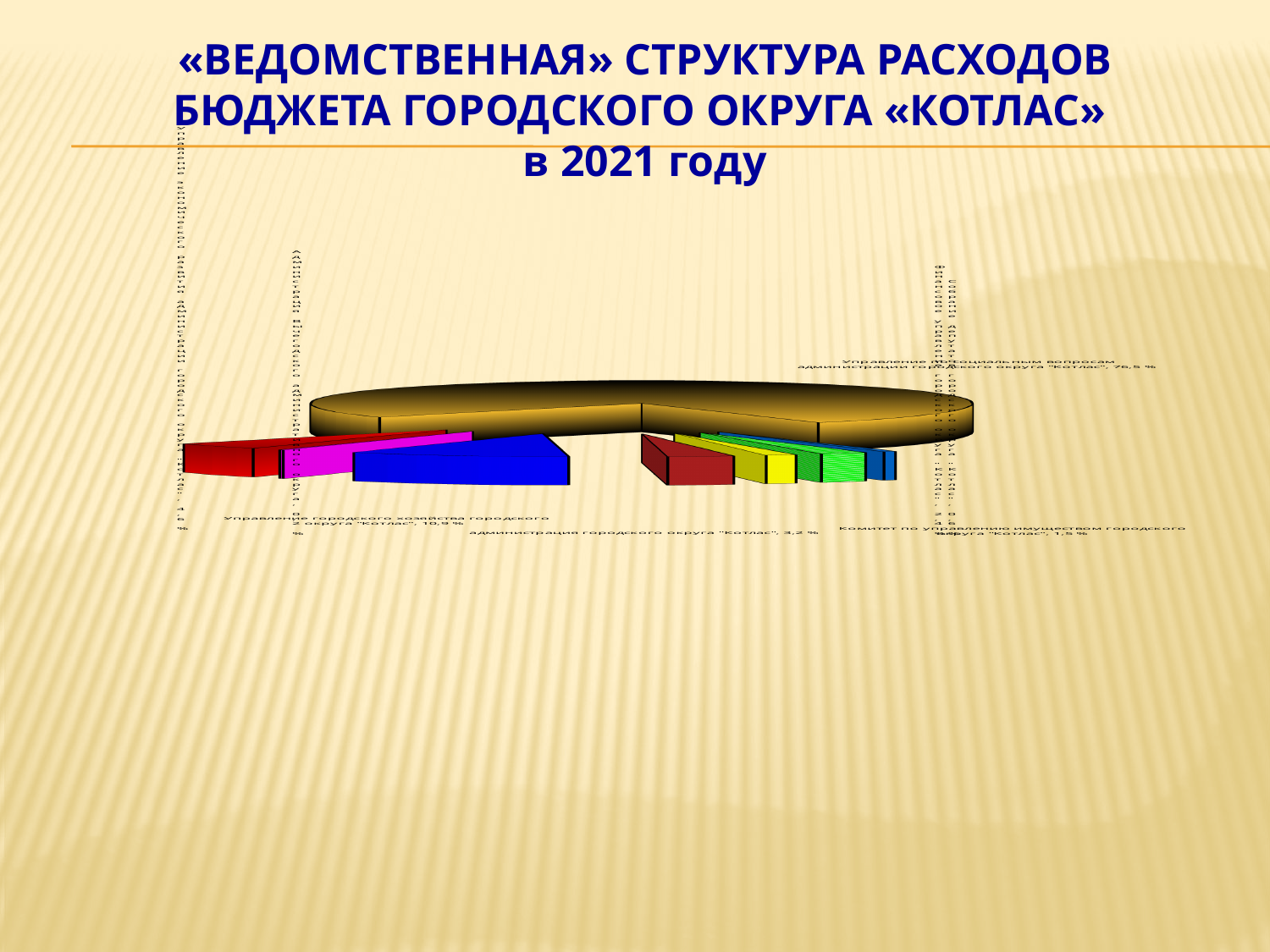
Which has a larger share: Управление городского хозяйства or администрация городского округа "Котлас"? Управление городского хозяйства By how many percentage points does the share of Управление по социальным вопросам exceed that of Управление городского хозяйства? 65,6 % Which year does the chart's title refer to? 2021 What is the title of the slide? «Ведомственная» структура расходов бюджета городского округа «Котлас» в 2021 году By how many percentage points does the share of администрация городского округа "Котлас" exceed that of Комитет по управлению имуществом? 1,7 % Which department has the largest share of the budget expenditures? Управление по социальным вопросам администрации городского округа "Котлас" What share of expenditures is attributed to Комитет по управлению имуществом городского округа "Котлас"? 1,5 % What share of expenditures is attributed to Управление по социальным вопросам администрации городского округа "Котлас"? 76,5 % What share of expenditures is attributed to Управление городского хозяйства городского округа "Котлас"? 10,9 % What share of expenditures is attributed to администрация городского округа "Котлас"? 3,2 % What kind of chart is shown on the slide? pie chart Which has a larger share: администрация городского округа "Котлас" or Комитет по управлению имуществом? администрация городского округа "Котлас"